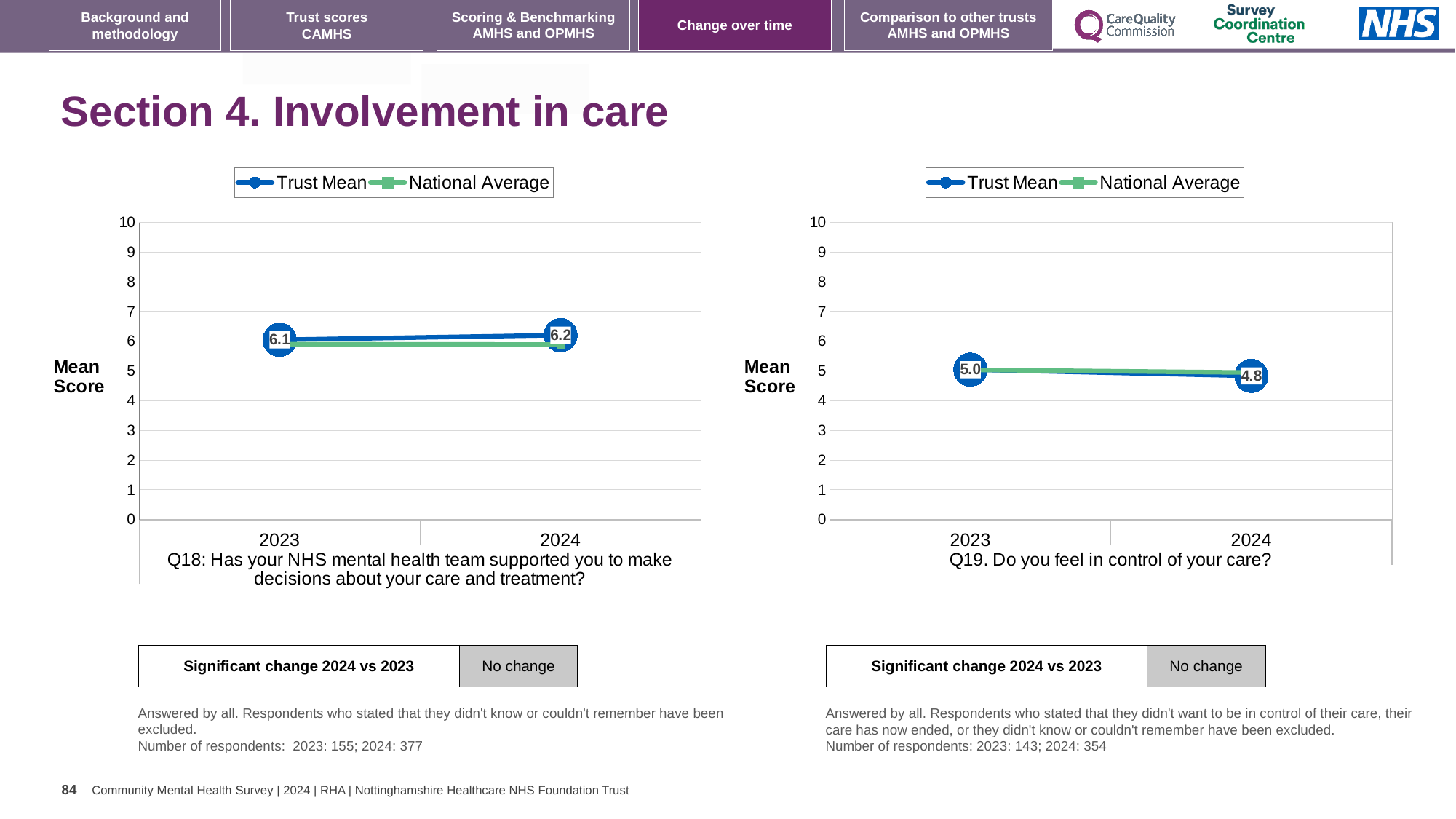
In the right chart (Q19), by how much did the Trust Mean change from 2023 to 2024? 0.2 In the left chart (Q18), does the Trust Mean rise or fall from 2023 to 2024? rise In the left chart (Q18), is the National Average value for 2023 greater or less than 5? greater In the right chart (Q19), what is the Trust Mean value for 2024? 4.8 In the left chart (Q18), what is the difference between the Trust Mean for 2024 and 2023? 0.1 What kind of chart is the left chart (Q18)? line chart In the left chart (Q18), what is the Trust Mean value for 2023? 6.1 How many years are shown on the x axis of the right chart (Q19)? 2 In the right chart (Q19), what is the Trust Mean value for 2023? 5.0 How many series does the legend of the right chart (Q19) list? 2 In the left chart (Q18), what is the Trust Mean value for 2024? 6.2 In the right chart (Q19), does the Trust Mean rise or fall from 2023 to 2024? fall